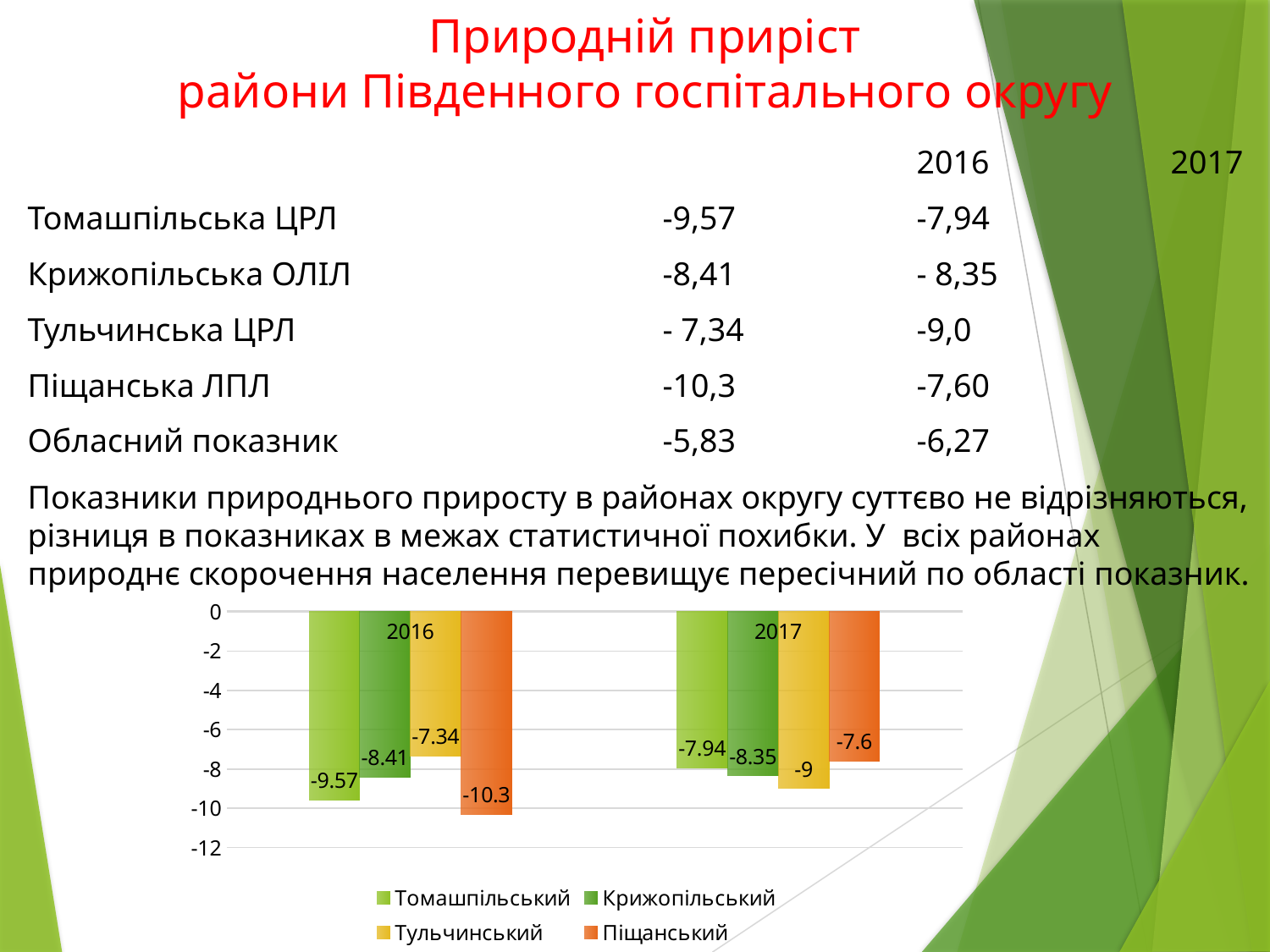
Which series has the lowest value in 2017? Тульчинський Does the Томашпільський value rise or fall from 2016 to 2017? Rises What kind of chart is shown on the slide? Bar chart What is the value for Піщанський in 2017? -7.6 How many year groups are shown on the x axis? 2 What is the value for Томашпільський in 2016? -9.57 Which series has the lowest value in 2016? Піщанський Which series has the highest value in 2017? Піщанський Which is larger, the Крижопільський value in 2016 or the Тульчинський value in 2016? Тульчинський value in 2016 How many series does the legend list? 4 What is the difference between the Піщанський values for 2016 and 2017? 2.7 What is the value for Тульчинський in 2017? -9